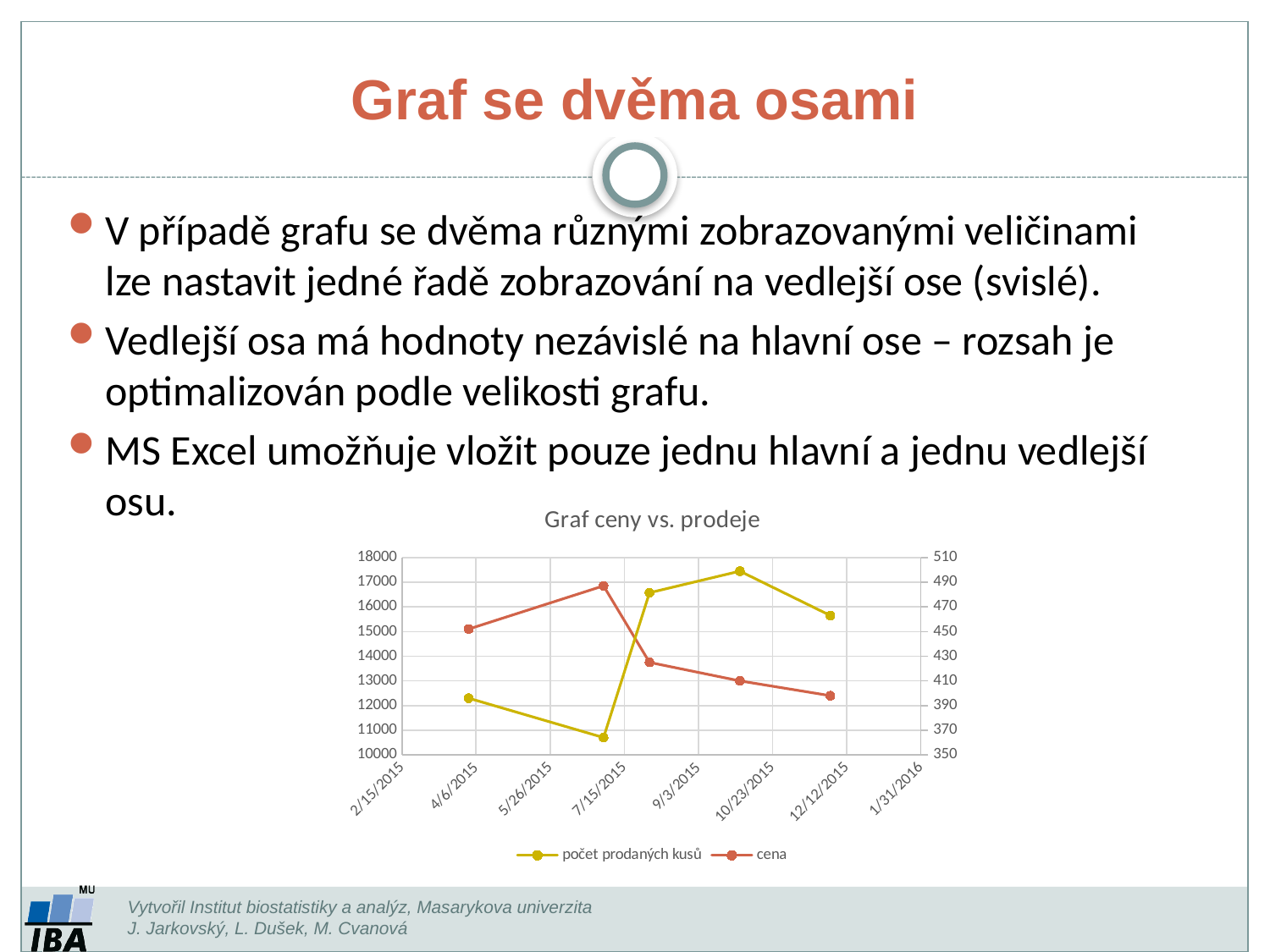
What is the title of the chart? Graf ceny vs. prodeje What are the two series named in the legend? počet prodaných kusů, cena Does the series cena rise or fall from its second point to its last point? fall How many data points are plotted for the series cena? 5 Is the last plotted value of cena greater or less than 410? less What kind of chart is shown on the slide? line chart Is the highest plotted value of počet prodaných kusů greater or less than 17000? greater How many data points are plotted for the series počet prodaných kusů? 5 Is the first plotted value of počet prodaných kusů greater or less than 14000? less How many series does the chart's legend list? 2